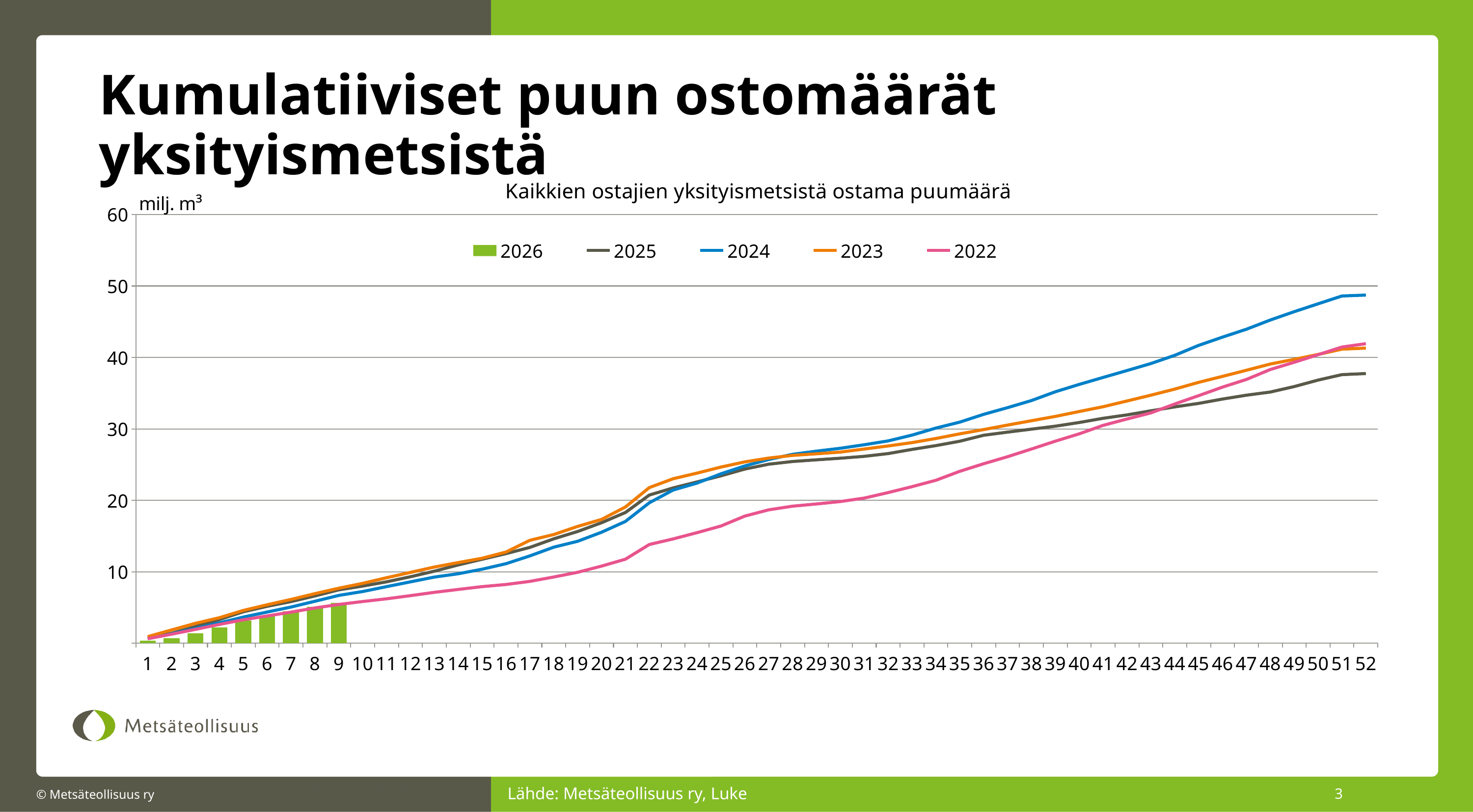
At week 30, which is larger: the value for 2024 or the value for 2022? 2024 How many series does the chart legend list? 5 How many points (weeks) are labelled along the x axis? 52 What kind of chart is shown on the slide? A combined bar and line chart Do the line series rise or fall along the x axis from week 1 to week 52? rise Which series has the highest value at week 52? 2024 Is the value for 2022 at week 26 greater or less than 20? less What is the unit shown on the y axis? milj. m³ Is the value for 2025 at week 52 greater or less than 40? less Which series has the lowest value at week 52? 2025 Is the value for 2024 at week 52 greater or less than 40? greater Which series is drawn as bars rather than a line? 2026